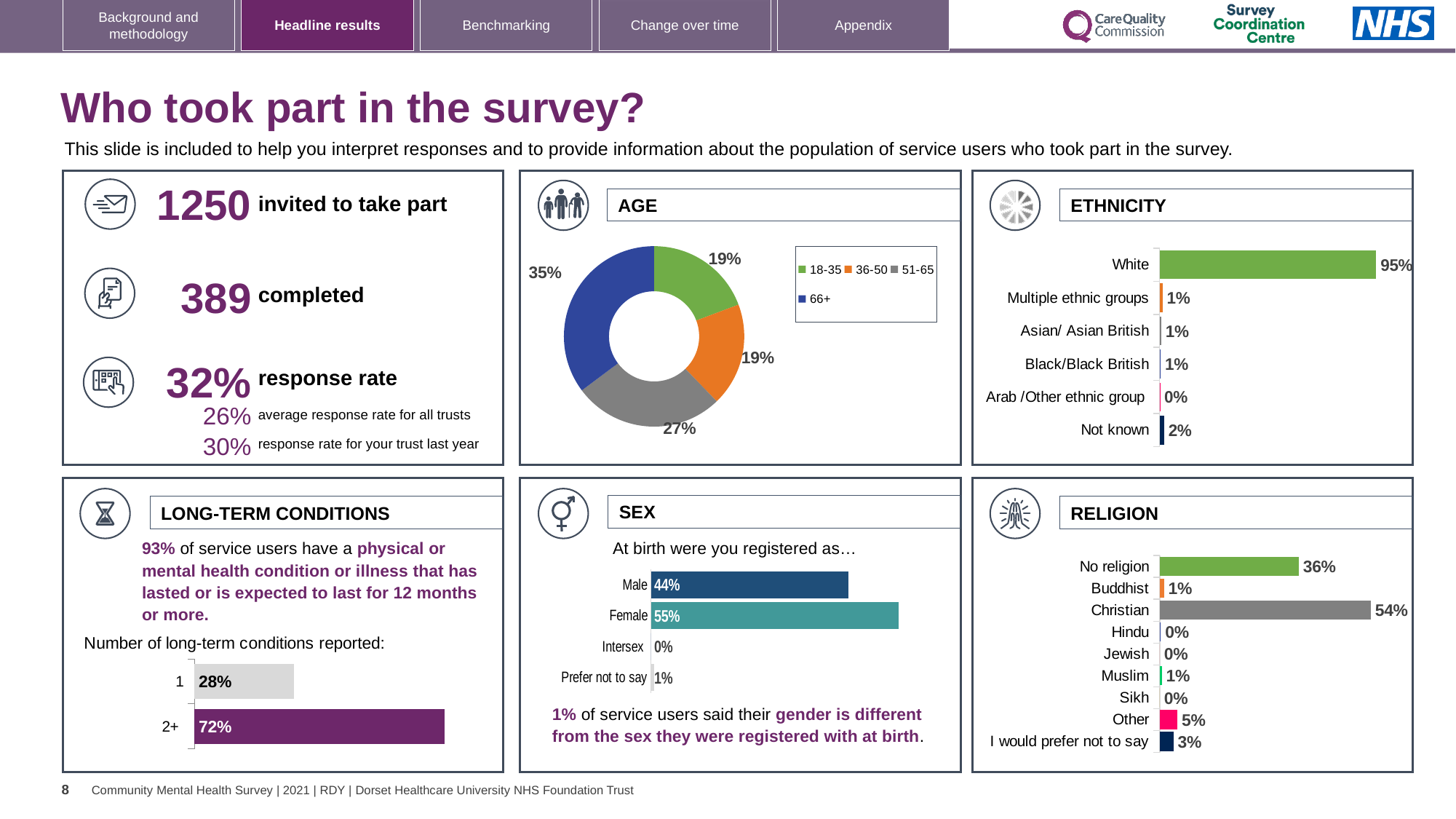
In the RELIGION chart, which category has the highest value? Christian In the LONG-TERM CONDITIONS chart, what is the difference between the value for 2+ and the value for 1? 44% In the ETHNICITY chart, what is the value for White? 95% In the ETHNICITY chart, what is the value for Not known? 2% In the SEX chart, which is larger, the value for Male or the value for Female? Female In the AGE chart, which age group has the largest share? 66+ How many entries does the legend of the AGE chart list? 4 In the AGE chart, what share of respondents were aged 66+? 35% How many categories are shown in the ETHNICITY chart? 6 In the RELIGION chart, what is the value for Other? 5% What kind of chart is the AGE chart? Donut (pie) chart In the SEX chart, what is the value for Prefer not to say? 1%